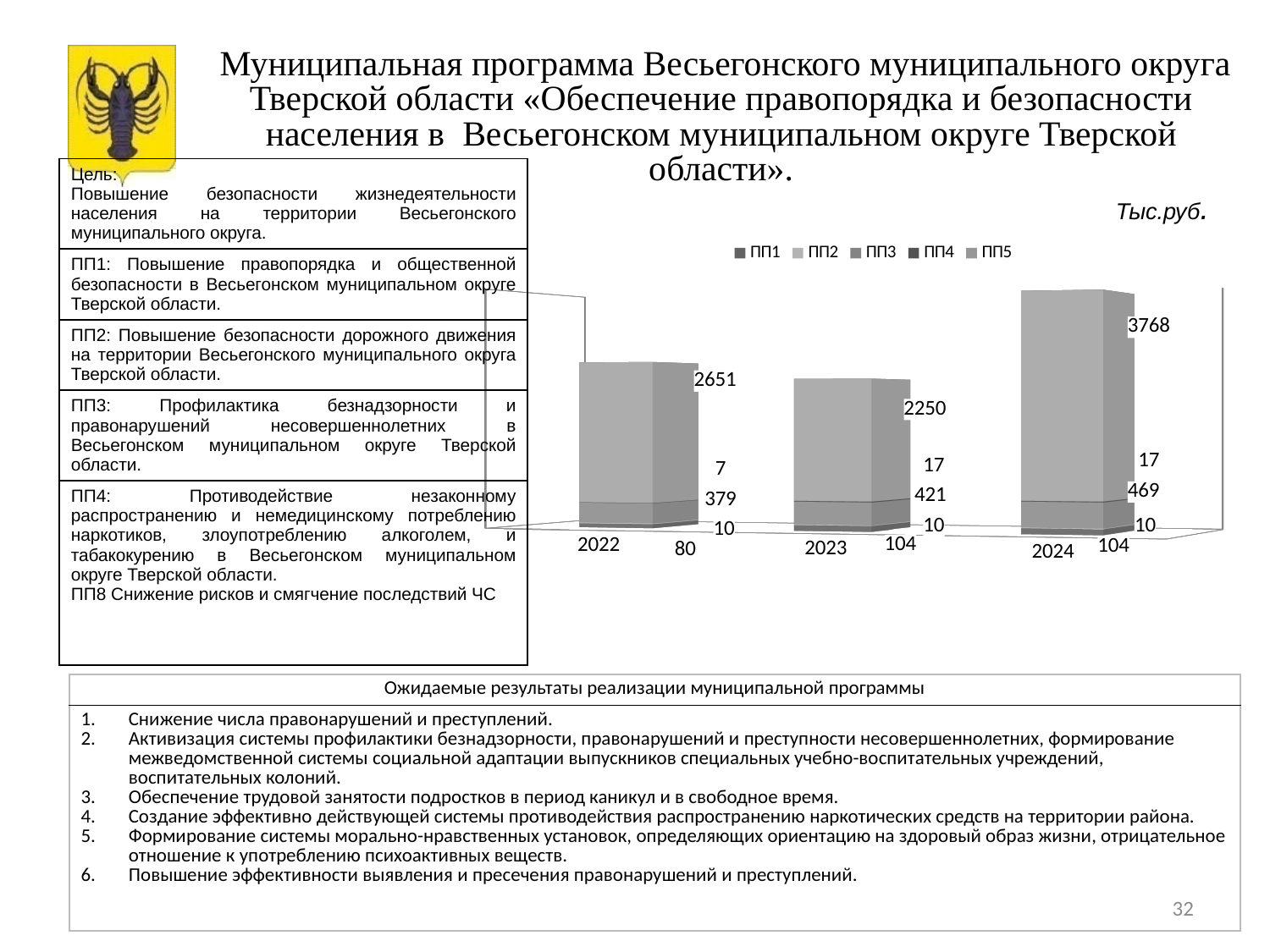
What is the value of ПП5 for 2024? 3768 What is the total of the stacked bar for 2022? 3127 Which year has the larger ПП3 value, 2022 or 2023? 2023 In which year is the value of ПП5 the lowest? 2023 In which year is the value of ПП5 the highest? 2024 How many series does the chart legend list? 5 How many years are shown on the x axis of the chart? 3 What kind of chart is shown on the slide? bar chart What is the value of ПП3 for 2024? 469 What is the difference between the ПП5 values for 2024 and 2023? 1518 What is the value of ПП5 for 2022? 2651 What unit is indicated above the chart? Тыс.руб.